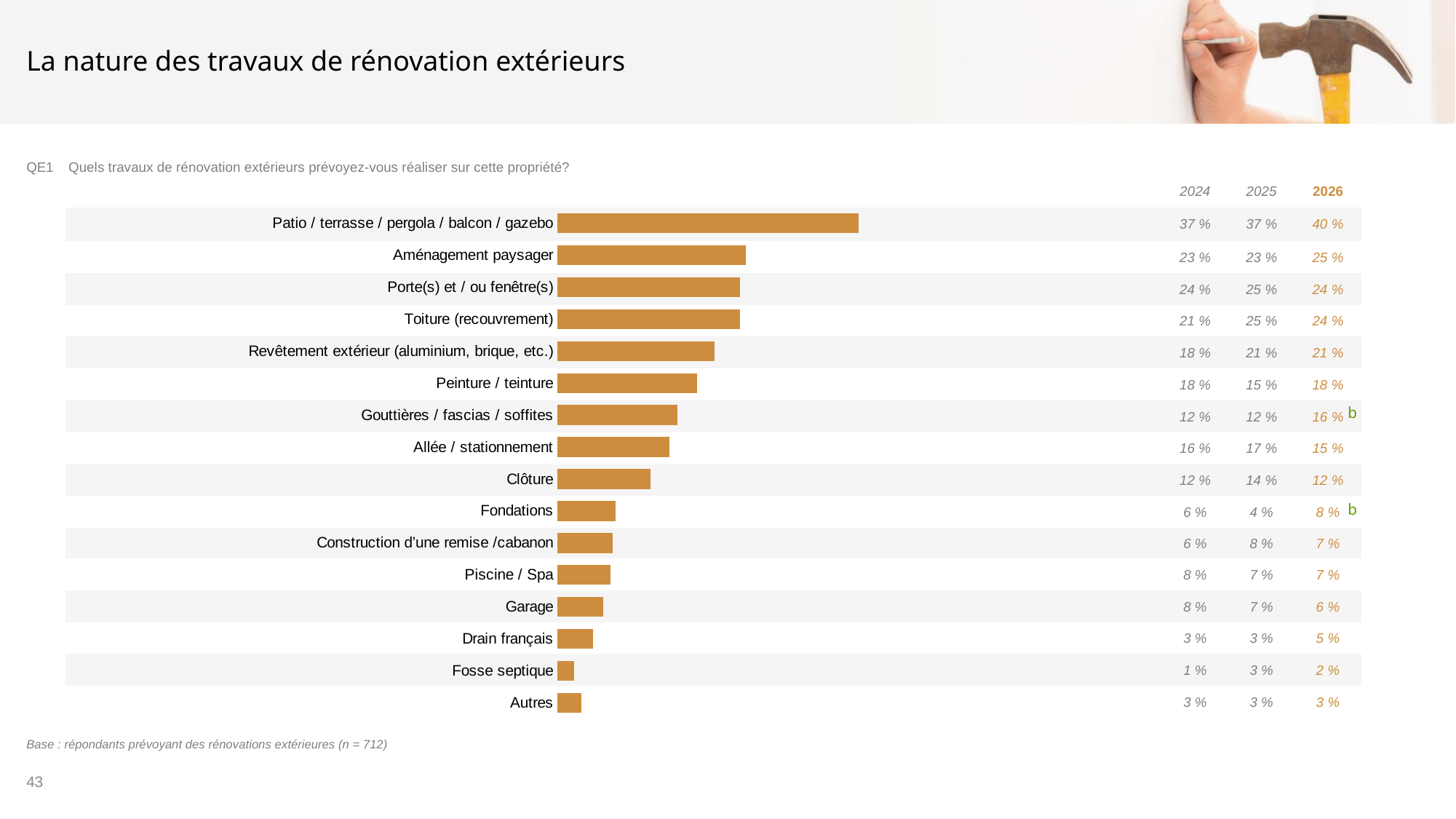
What kind of chart is shown on the slide? Bar chart What is the difference between the 2026 values for Aménagement paysager and Clôture? 13 % What is the 2025 value for Fondations? 4 % What is the base size (n) stated below the chart? 712 What is the 2024 value for Toiture (recouvrement)? 21 % How many years of values are listed in the table next to the chart? 3 What is the 2026 value for Patio / terrasse / pergola / balcon / gazebo? 40 % Which category has the lowest 2026 value? Fosse septique Which has a larger 2026 value, Peinture / teinture or Allée / stationnement? Peinture / teinture What is the difference between the 2024 and 2026 values for Gouttières / fascias / soffites? 4 % Which category has the highest 2026 value? Patio / terrasse / pergola / balcon / gazebo How many categories are shown in the bar chart? 16